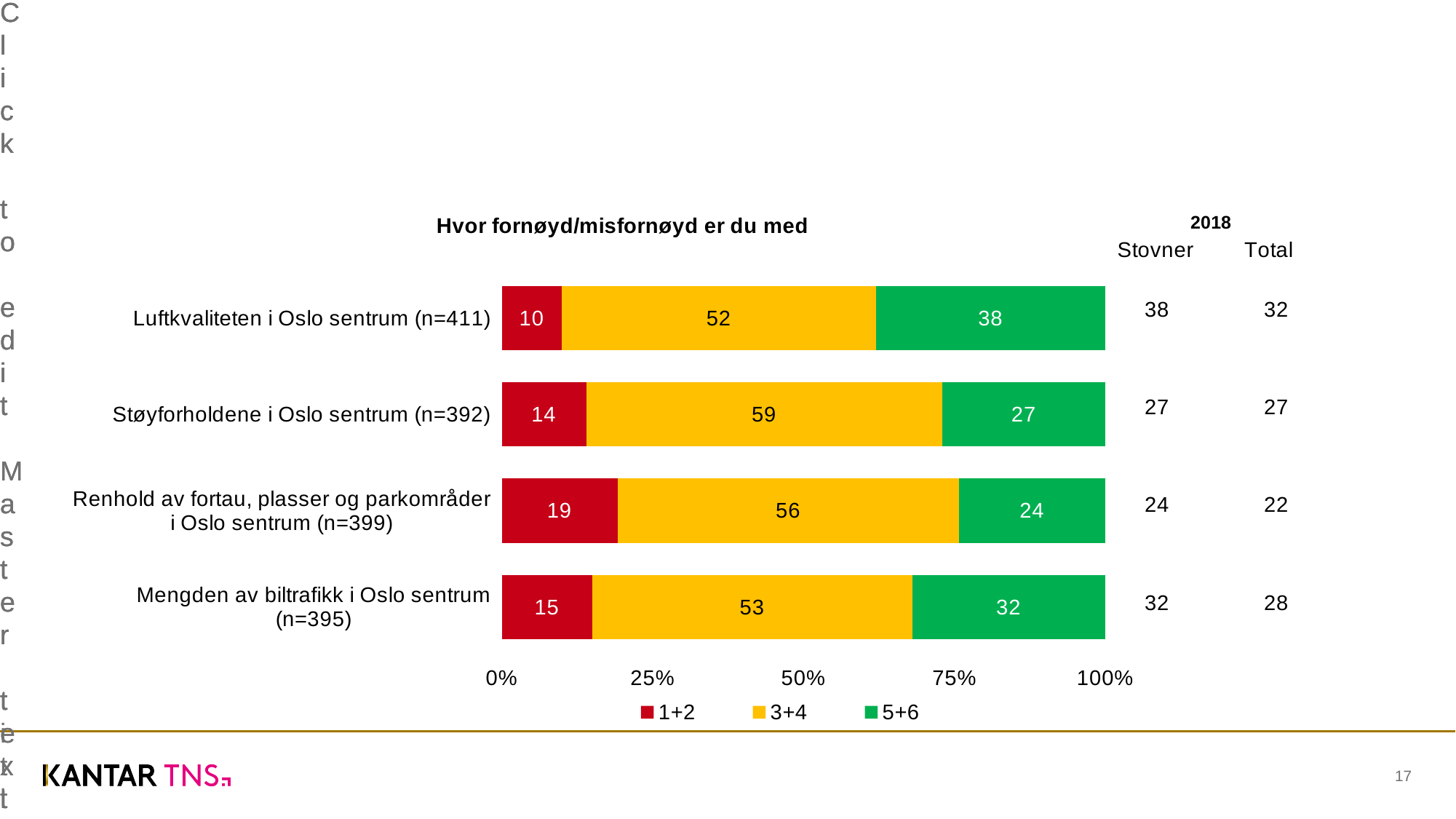
What is the title of the chart? Hvor fornøyd/misfornøyd er du med What is the value of the 1+2 series for "Renhold av fortau, plasser og parkområder i Oslo sentrum (n=399)"? 19 Which category has the lowest value for the 5+6 series? Renhold av fortau, plasser og parkområder i Oslo sentrum (n=399) Which is larger: the 3+4 value for "Støyforholdene i Oslo sentrum (n=392)" or the 3+4 value for "Luftkvaliteten i Oslo sentrum (n=411)"? Støyforholdene i Oslo sentrum (n=392) How many series does the legend list? 3 What is the total of the stacked bar for "Mengden av biltrafikk i Oslo sentrum (n=395)"? 100 What is the difference between the 5+6 values for "Luftkvaliteten i Oslo sentrum (n=411)" and "Mengden av biltrafikk i Oslo sentrum (n=395)"? 6 What is the value of the 3+4 series for "Støyforholdene i Oslo sentrum (n=392)"? 59 What kind of chart is shown on the slide? Stacked bar chart What is the value of the 5+6 series for "Luftkvaliteten i Oslo sentrum (n=411)"? 38 How many categories are plotted in the chart? 4 Which category has the highest value for the 1+2 series? Renhold av fortau, plasser og parkområder i Oslo sentrum (n=399)